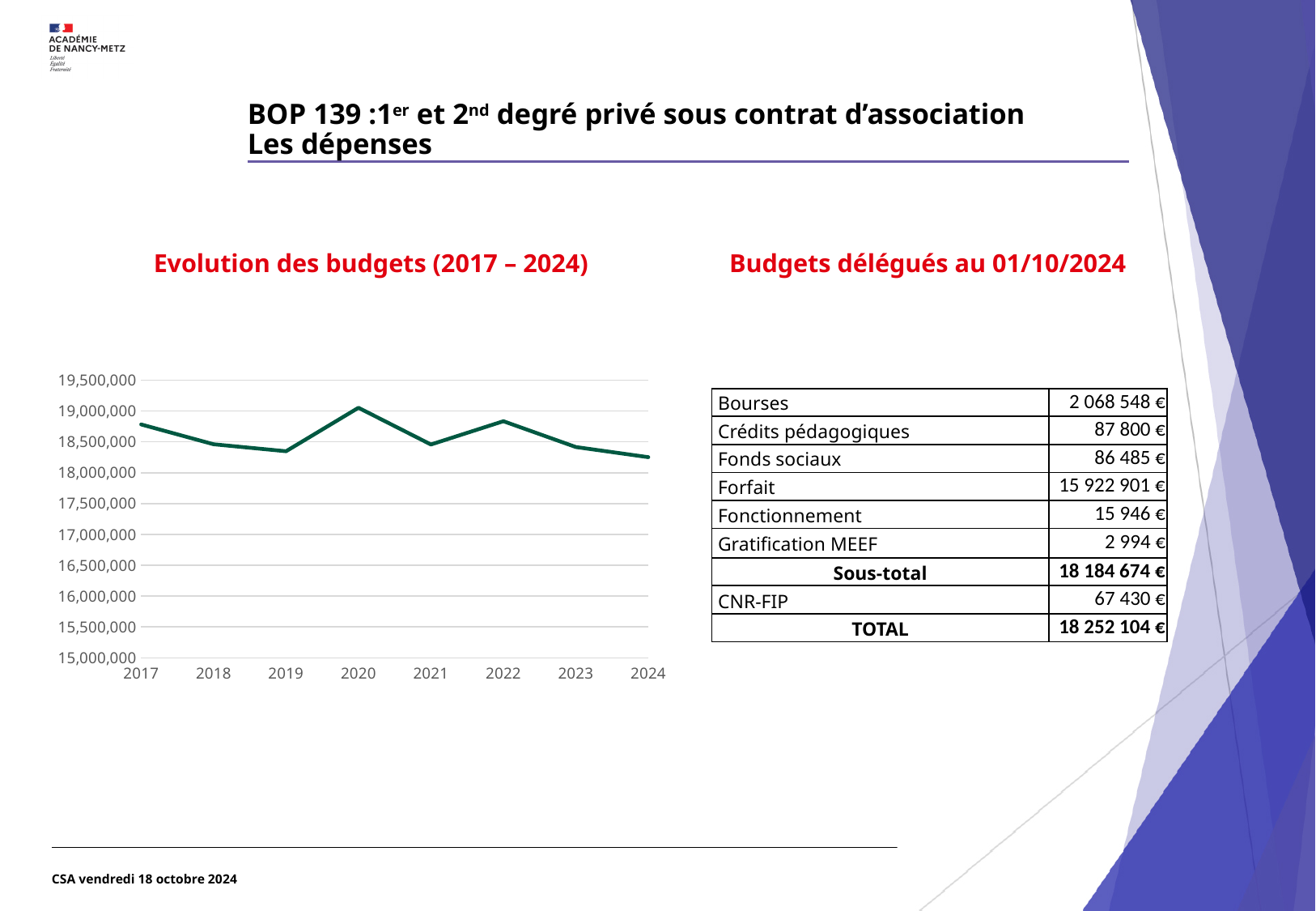
In the 'Evolution des budgets (2017 – 2024)' chart, which year has the larger value, 2022 or 2023? 2022 In the 'Evolution des budgets (2017 – 2024)' chart, is the value for 2019 greater or less than 18,000,000? greater In the 'Evolution des budgets (2017 – 2024)' chart, which year has the larger value, 2020 or 2021? 2020 In the 'Evolution des budgets (2017 – 2024)' chart, is the value for 2020 greater or less than 19,000,000? greater In the 'Evolution des budgets (2017 – 2024)' chart, is the value for 2024 greater or less than 18,500,000? less What kind of chart is shown under the title 'Evolution des budgets (2017 – 2024)'? line chart In the 'Evolution des budgets (2017 – 2024)' chart, do the values rise or fall from 2022 to 2024? fall How many years are plotted on the x axis of the 'Evolution des budgets (2017 – 2024)' chart? 8 What is the lowest value shown on the y axis of the 'Evolution des budgets (2017 – 2024)' chart? 15,000,000 In the 'Evolution des budgets (2017 – 2024)' chart, do the values rise or fall from 2019 to 2020? rise In the 'Evolution des budgets (2017 – 2024)' chart, which year has the highest value? 2020